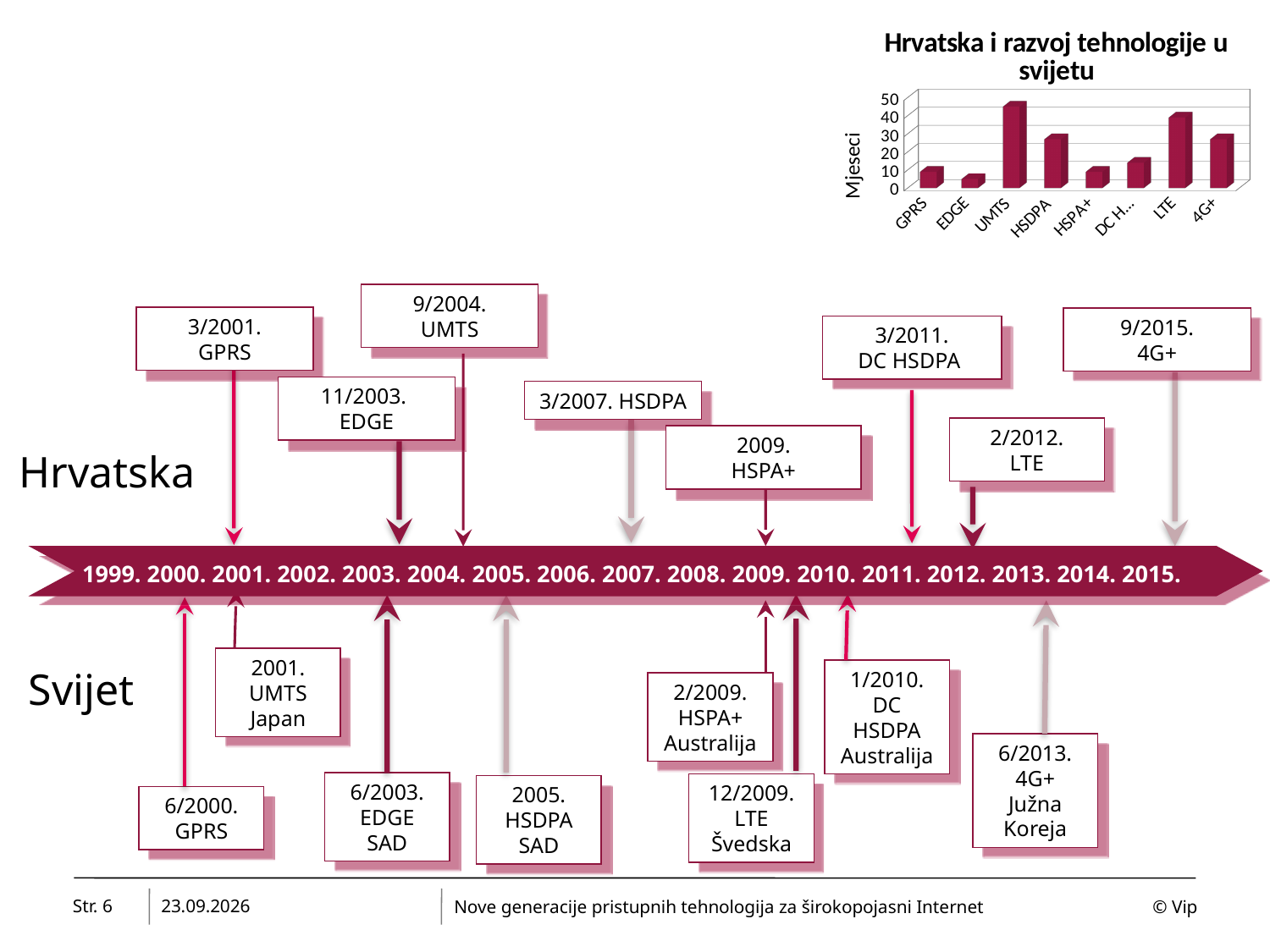
Which category has the highest value in the chart? UMTS What is the label on the vertical axis of the chart? Mjeseci Which is larger in the chart, the value for UMTS or the value for HSDPA? UMTS Which is larger in the chart, the value for LTE or the value for HSPA+? LTE Is the value for GPRS greater or less than 20? less What kind of chart is shown on the slide? bar chart Is the value for EDGE greater or less than 10? less Is the value for HSDPA greater or less than 20? greater Which category has the lowest value in the chart? EDGE How many categories are shown on the x axis of the chart? 8 What is the title of the chart? Hrvatska i razvoj tehnologije u svijetu